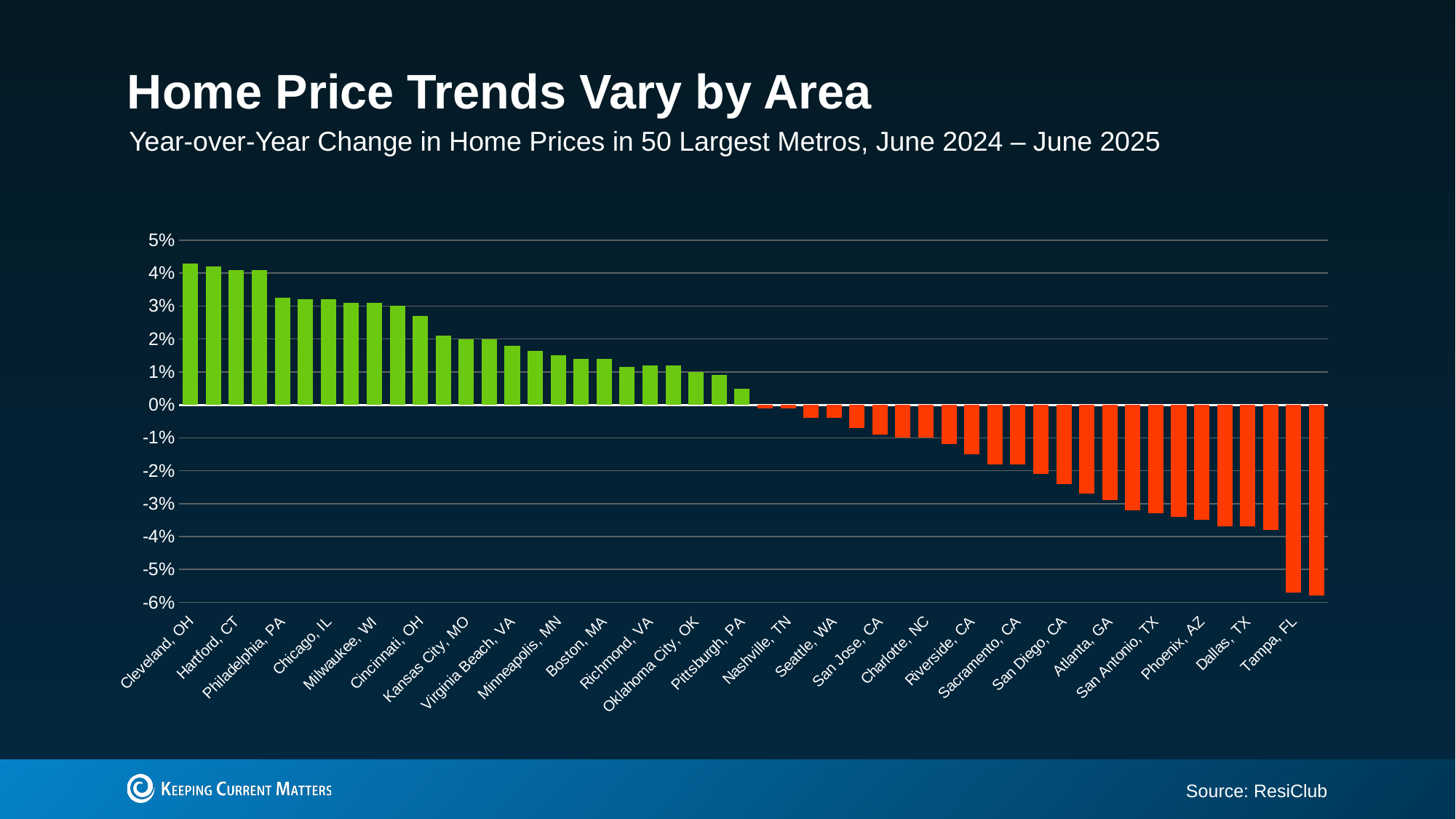
Is the value for Atlanta, GA greater or less than -2%? less Which has the larger year-over-year change, Cleveland, OH or Tampa, FL? Cleveland, OH Is the value for Tampa, FL greater or less than -5%? less Is the value for Cincinnati, OH greater or less than 3%? less What kind of chart is shown on the slide? Bar chart Which has the larger year-over-year change, Chicago, IL or Dallas, TX? Chicago, IL How many metros are plotted in the chart, according to the subtitle? 50 Do the values rise or fall moving from left to right along the x axis? Fall What is the title of the slide? Home Price Trends Vary by Area